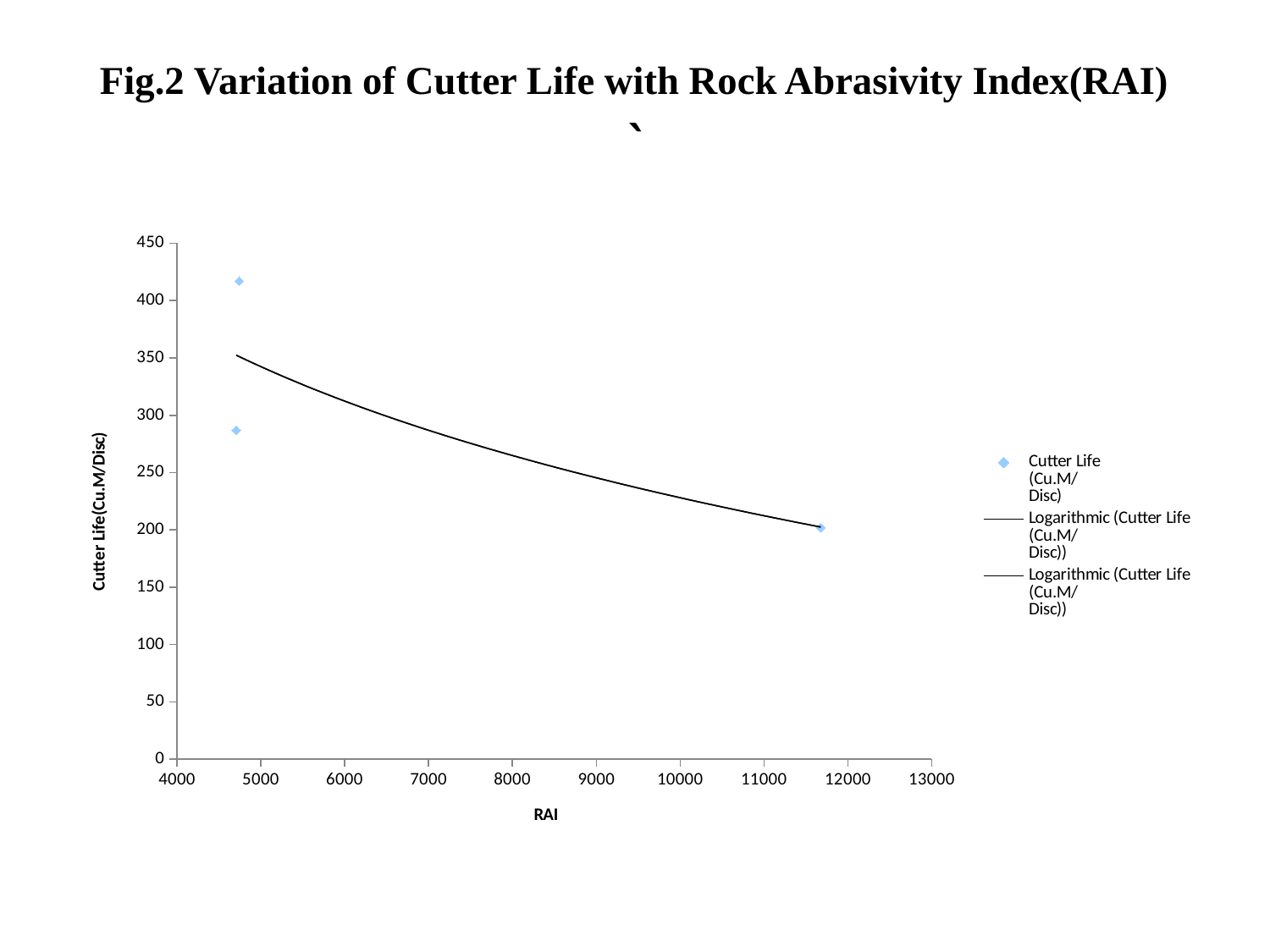
How many data points are plotted for Cutter Life (Cu.M/Disc)? 3 What kind of chart is shown on the slide? scatter chart Does the logarithmic trendline rise or fall as RAI increases? fall Which has the larger Cutter Life: the point near RAI 11700 or the highest point near RAI 4700? the highest point near RAI 4700 Is the Cutter Life value for the point near RAI 11700 greater or less than 150? greater What is the title of the chart? Fig.2 Variation of Cutter Life with Rock Abrasivity Index(RAI) How many entries does the legend list? 3 What is the label of the x axis? RAI Is the highest plotted Cutter Life value greater or less than 400? greater Is the lowest plotted Cutter Life value greater or less than 250? less